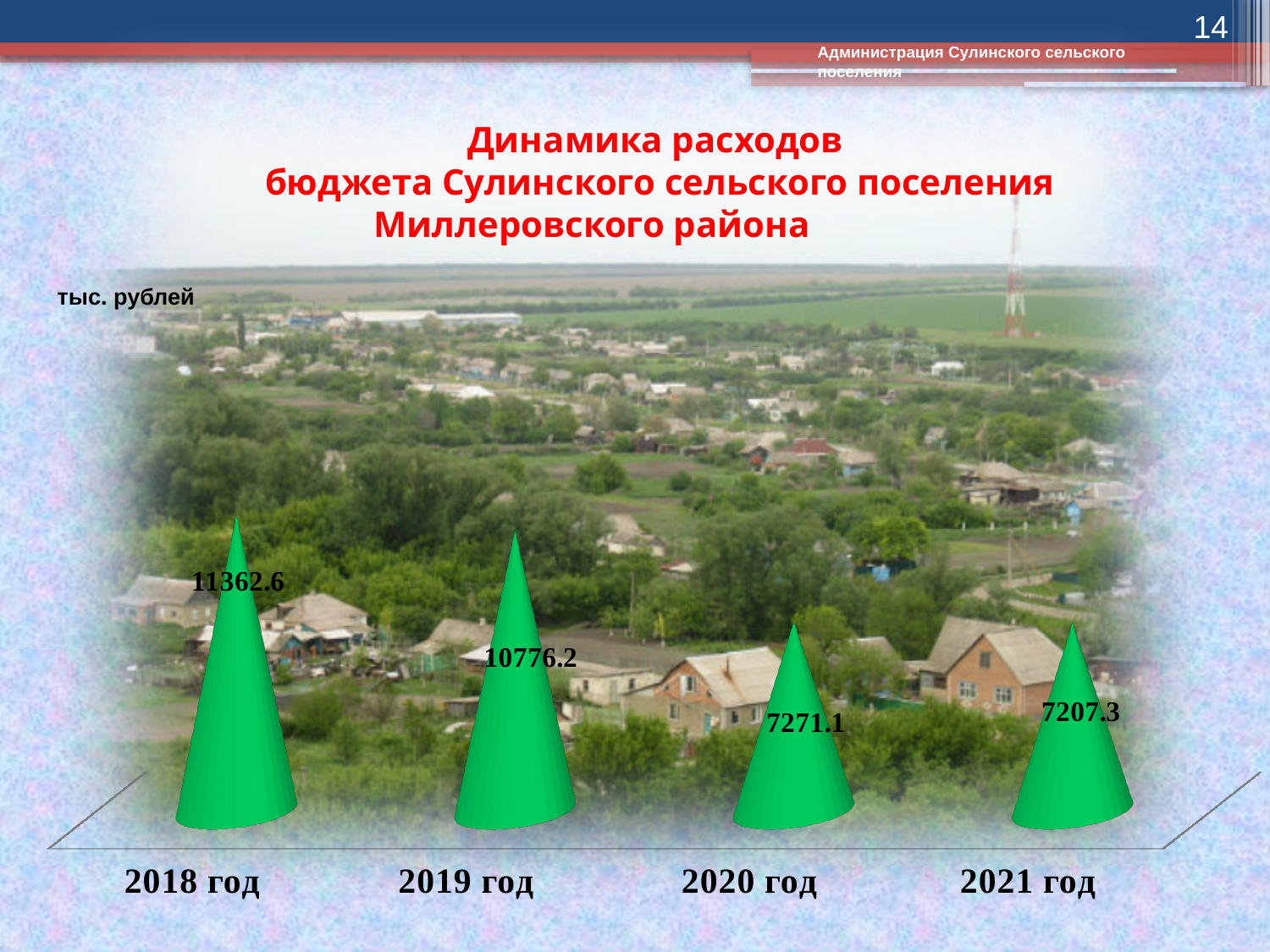
What is the value for 2019 год? 10776.2 What unit of measurement is indicated for the chart values? тыс. рублей How many years are shown on the chart? 4 Which is larger, the value for 2019 год or the value for 2020 год? 2019 год What is the value for 2020 год? 7271.1 What is the difference between the values for 2020 год and 2021 год? 63.8 Do the values rise or fall from 2018 год to 2021 год? fall What is the value for 2021 год? 7207.3 Which year has the lowest value? 2021 год What is the difference between the values for 2018 год and 2019 год? 586.4 What is the value for 2018 год? 11362.6 Which year has the highest value? 2018 год